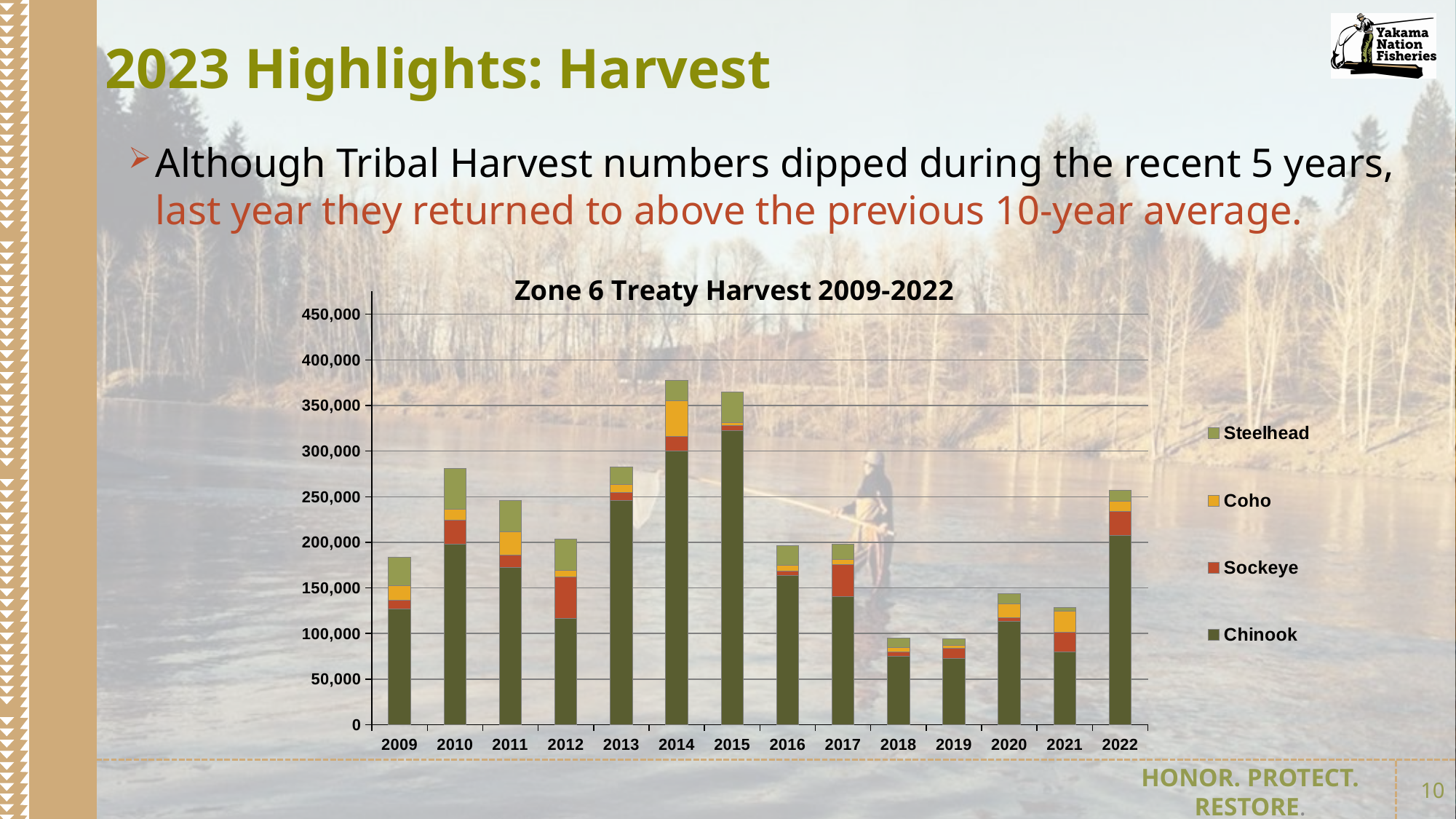
Is the total harvest for 2018 greater or less than 100,000? less Which year has the highest total harvest in the chart? 2014 Is the total harvest for 2009 greater or less than 200,000? less Is the total harvest for 2014 greater or less than 350,000? greater What is the title of the chart? Zone 6 Treaty Harvest 2009-2022 Do the total harvest values rise or fall from 2015 to 2019? fall What kind of chart is shown on the slide? Stacked bar chart How many years are shown along the x axis of the chart? 14 How many series does the chart's legend list? 4 Which year has the larger total harvest, 2010 or 2011? 2010 Which year has the larger total harvest, 2021 or 2022? 2022